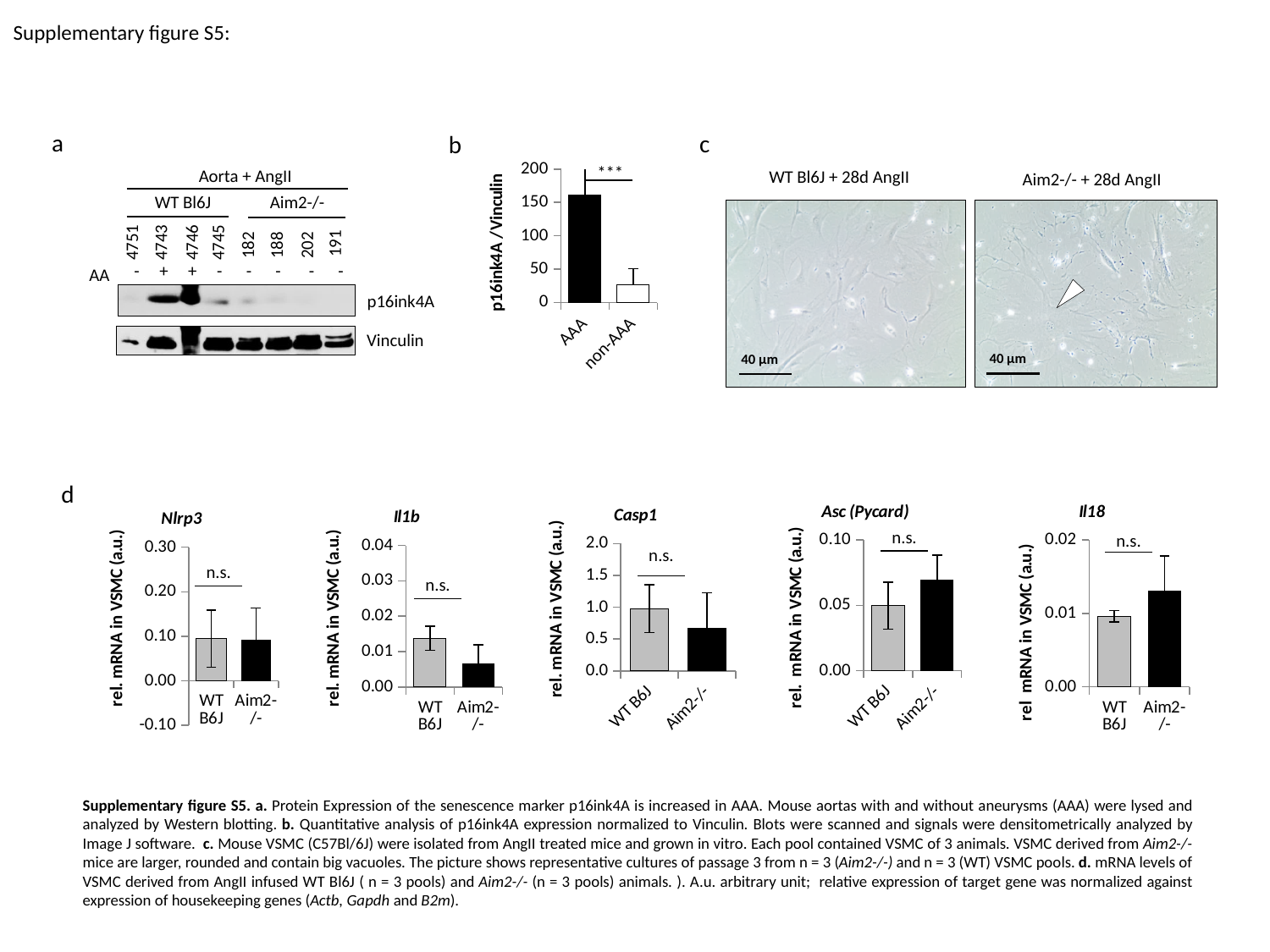
How many categories are shown on the x axis of the chart in panel b (p16ink4A /Vinculin)? 2 In the chart in panel b (p16ink4A /Vinculin), which category has the higher value, AAA or non-AAA? AAA In the chart in panel b (p16ink4A /Vinculin), is the value for AAA greater or less than 100? greater In the chart in panel b (p16ink4A /Vinculin), is the value for non-AAA greater or less than 50? less In the Casp1 chart in panel d, which group has the larger value, WT B6J or Aim2-/-? WT B6J In the Il1b chart in panel d, which group has the larger value, WT B6J or Aim2-/-? WT B6J How many bar charts are shown in panel d? 5 In the Il18 chart in panel d, is the value for Aim2-/- greater or less than 0.01? greater What kind of chart is used in panel b (p16ink4A /Vinculin)? bar chart